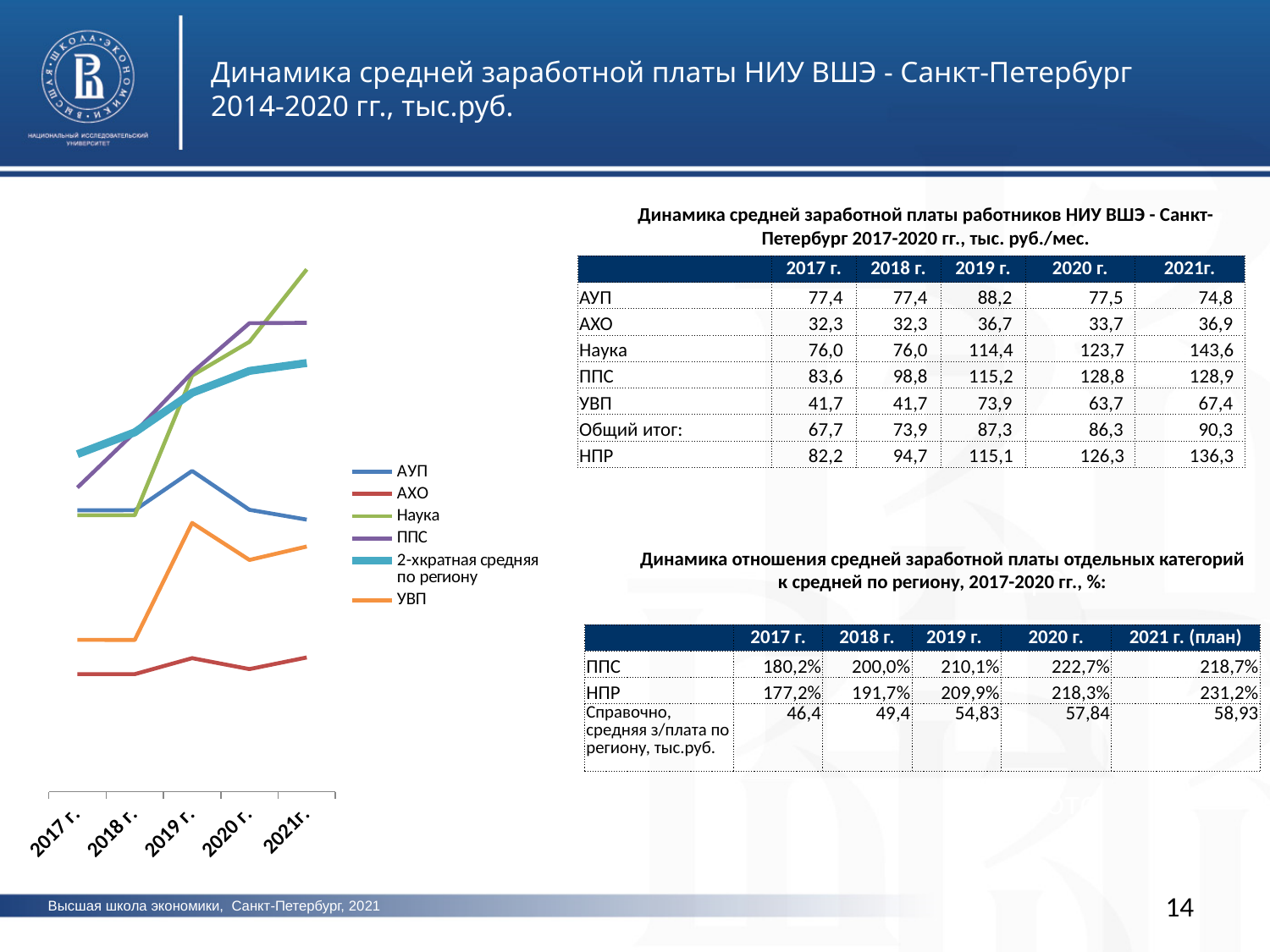
How many years are shown along the x axis of the line chart? 5 Which series in the line chart is drawn with the thick light-blue line? 2-хкратная средняя по региону What kind of chart is shown on the left of the slide? line chart In the line chart, which series has the highest value in 2021г.? Наука How many series does the legend of the line chart list? 6 In the line chart, does the Наука line rise or fall from 2018 г. to 2021г.? rise In the line chart, in which year does the АУП line reach its peak? 2019 г. In the line chart, which series has the lowest value in 2021г.? АХО In the line chart, does the АУП line rise or fall from 2019 г. to 2021г.? fall In the line chart, which series is lowest across all years shown? АХО In the line chart, which is higher in 2019 г.: АУП or УВП? АУП In the line chart, which is higher in 2021г.: Наука or ППС? Наука